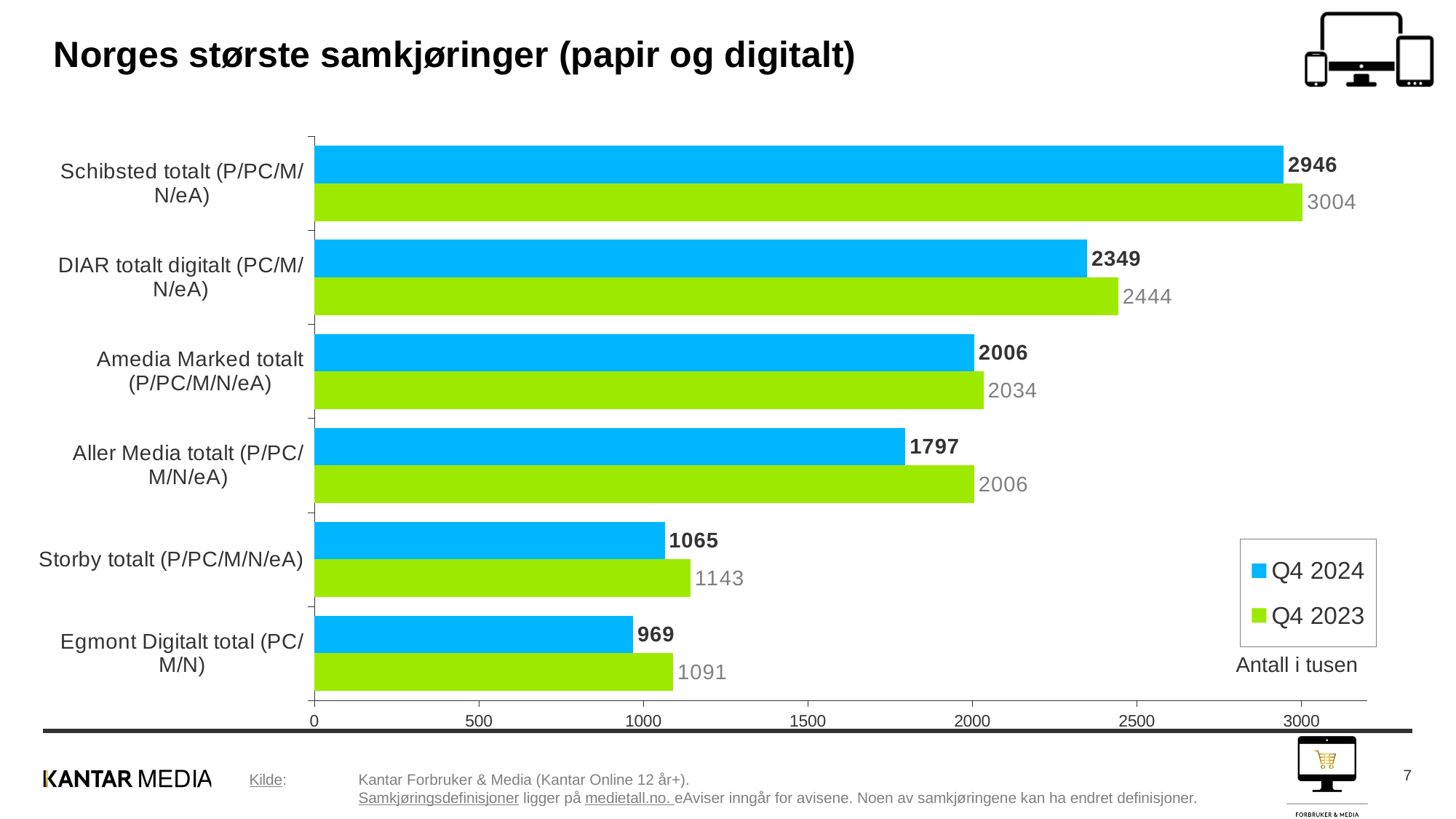
Which category has the lowest Q4 2023 value? Egmont Digitalt total (PC/M/N) What is the Q4 2023 value for Storby totalt (P/PC/M/N/eA)? 1143 Which category has the highest Q4 2024 value? Schibsted totalt (P/PC/M/N/eA) Which is larger for DIAR totalt digitalt (PC/M/N/eA): the Q4 2024 value or the Q4 2023 value? Q4 2023 How many series does the legend list? 2 Is the Q4 2024 value for Amedia Marked totalt (P/PC/M/N/eA) greater or less than 1500? greater What kind of chart is shown on the slide? Bar chart What is the title of the chart? Norges største samkjøringer (papir og digitalt) How many categories are shown on the chart? 6 What is the Q4 2024 value for Egmont Digitalt total (PC/M/N)? 969 What is the difference between the Q4 2023 and Q4 2024 values for Aller Media totalt (P/PC/M/N/eA)? 209 What is the Q4 2024 value for Schibsted totalt (P/PC/M/N/eA)? 2946